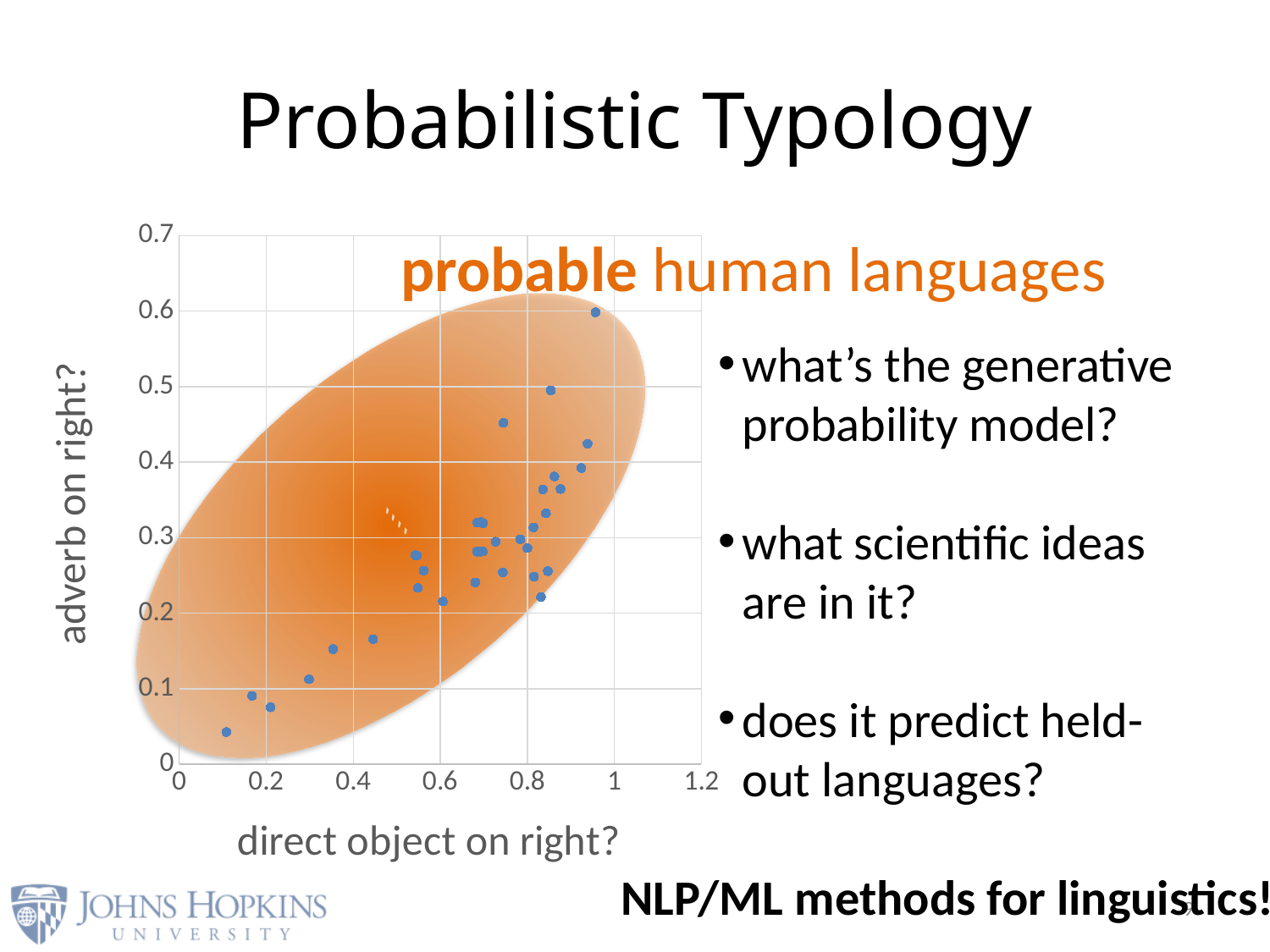
Is the x value of the highest point on the chart greater or less than 0.8? greater What kind of chart is shown on the slide? scatter plot Is the y value of the lowest point on the chart greater or less than 0.1? less Is the y value of the highest point on the chart greater or less than 0.7? less What is the label on the x axis of the chart? direct object on right? Do the plotted points generally rise or fall as the x value increases? rise What is the label on the y axis of the chart? adverb on right?